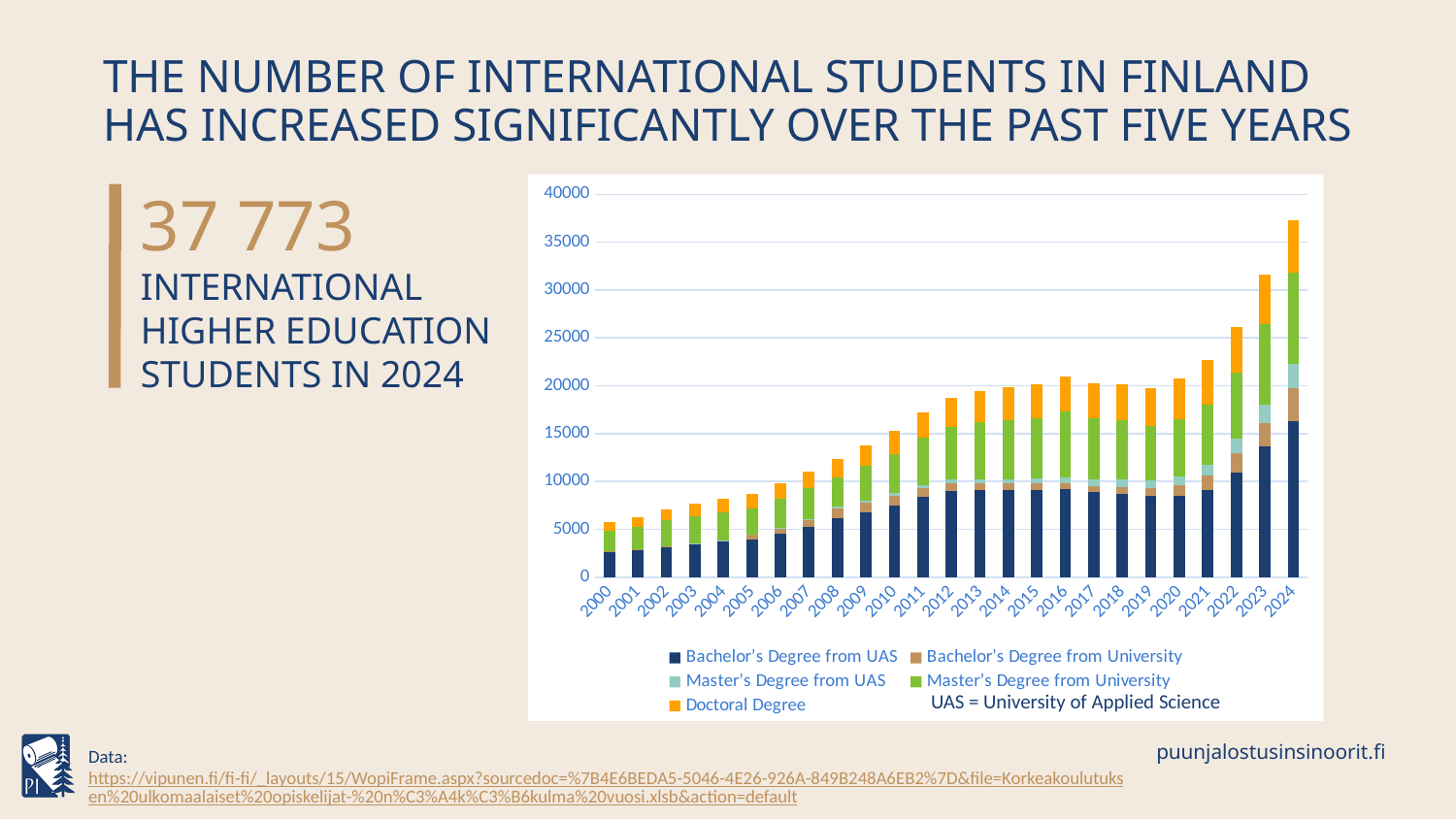
What kind of chart is shown on the slide? Stacked bar chart Is the total value for 2022 greater or less than 25000? greater Which year has a larger total, 2008 or 2012? 2012 Overall, do the total values rise or fall from 2000 to 2024? Rise Which year has the highest total number of international students in the chart? 2024 Which series is shown in dark blue at the bottom of each stacked bar? Bachelor's Degree from UAS Is the total value for 2024 greater or less than 35000? greater How many series does the chart legend list? 5 How many years are shown along the x axis of the chart? 25 According to the note below the legend, what does UAS stand for? University of Applied Science Which year has the lowest total number of international students in the chart? 2000 Is the total value for 2000 greater or less than 10000? less